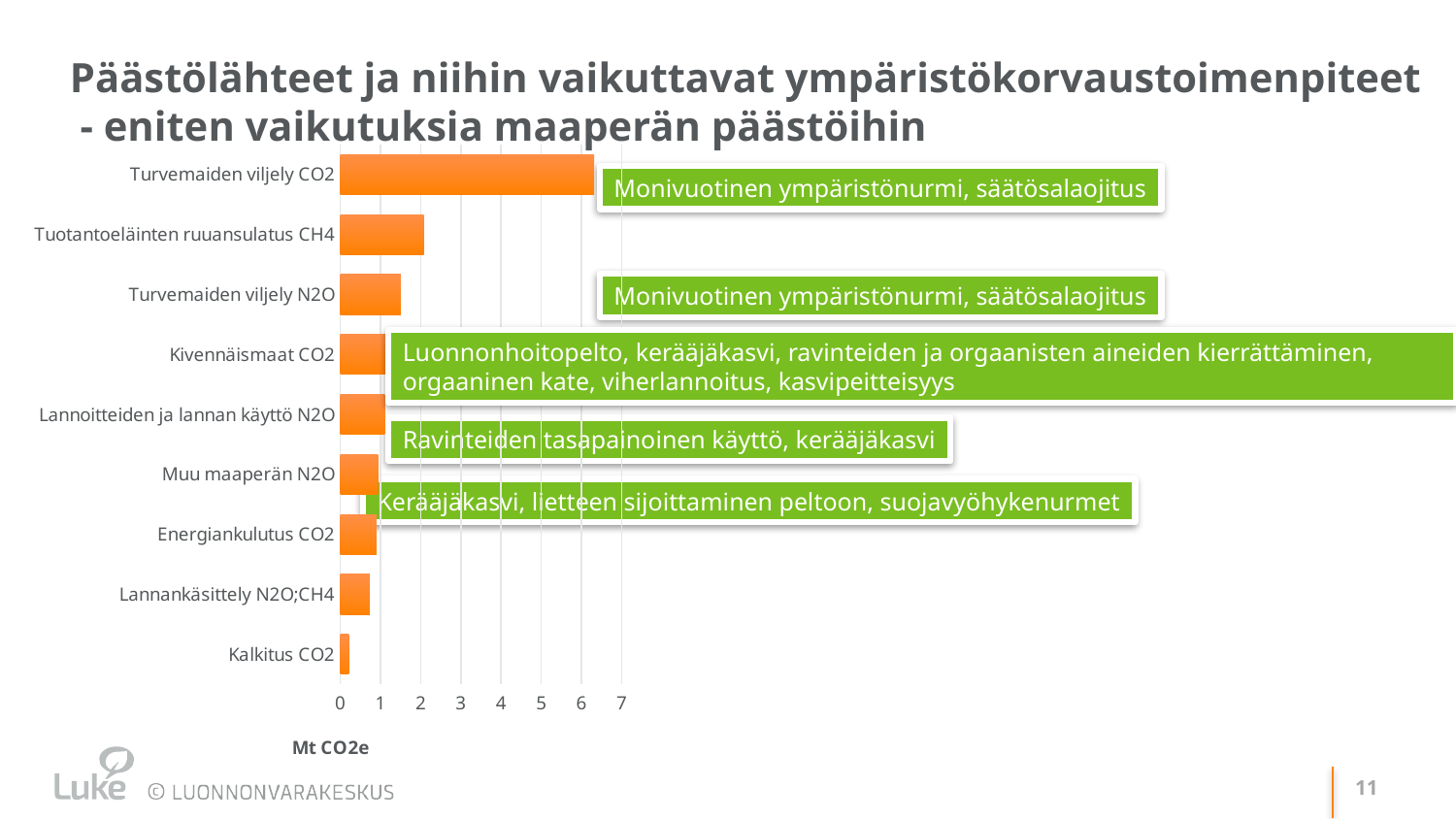
How many categories are plotted in the chart? 9 What kind of chart is shown on the slide? bar chart What unit is shown for the values on the x axis of the chart? Mt CO2e Which is larger, the value for Lannankäsittely N2O;CH4 or the value for Kalkitus CO2? Lannankäsittely N2O;CH4 Which is larger, the value for Tuotantoeläinten ruuansulatus CH4 or the value for Turvemaiden viljely N2O? Tuotantoeläinten ruuansulatus CH4 Is the value for Kalkitus CO2 greater or less than 1? less Which category has the highest value in the chart? Turvemaiden viljely CO2 Is the value for Turvemaiden viljely CO2 greater or less than 6? greater What is the highest tick value shown on the x axis of the chart? 7 Is the value for Turvemaiden viljely N2O greater or less than 1? greater Which category has the lowest value in the chart? Kalkitus CO2